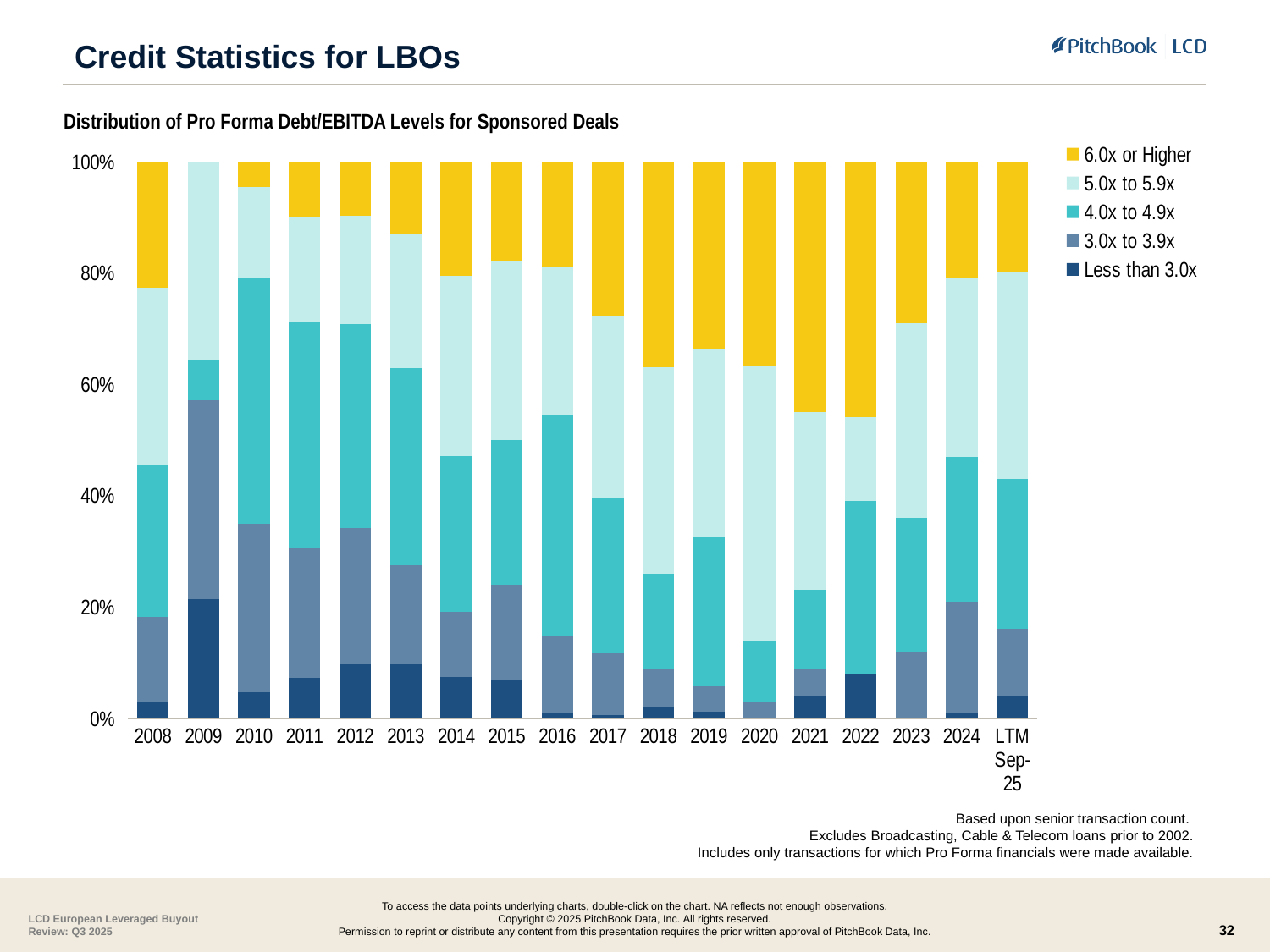
Is the share of Less than 3.0x deals larger in 2009 or in 2017? 2009 What kind of chart is shown on the slide? Stacked bar chart What is the title of the chart? Distribution of Pro Forma Debt/EBITDA Levels for Sponsored Deals Is the share of 6.0x or Higher deals larger in 2009 or in 2021? 2021 In 2009, is the share of Less than 3.0x deals greater or less than 40%? less How many series does the legend list? 5 Which year has the smallest share of deals in the 6.0x or Higher category? 2009 How many periods are shown along the x axis? 18 Which legend entry is listed first (at the top of the legend)? 6.0x or Higher In 2020, is the share of 5.0x to 5.9x deals greater or less than 40%? greater In 2021, is the share of 6.0x or Higher deals greater or less than 40%? greater Which year has the largest share of deals in the Less than 3.0x category? 2009